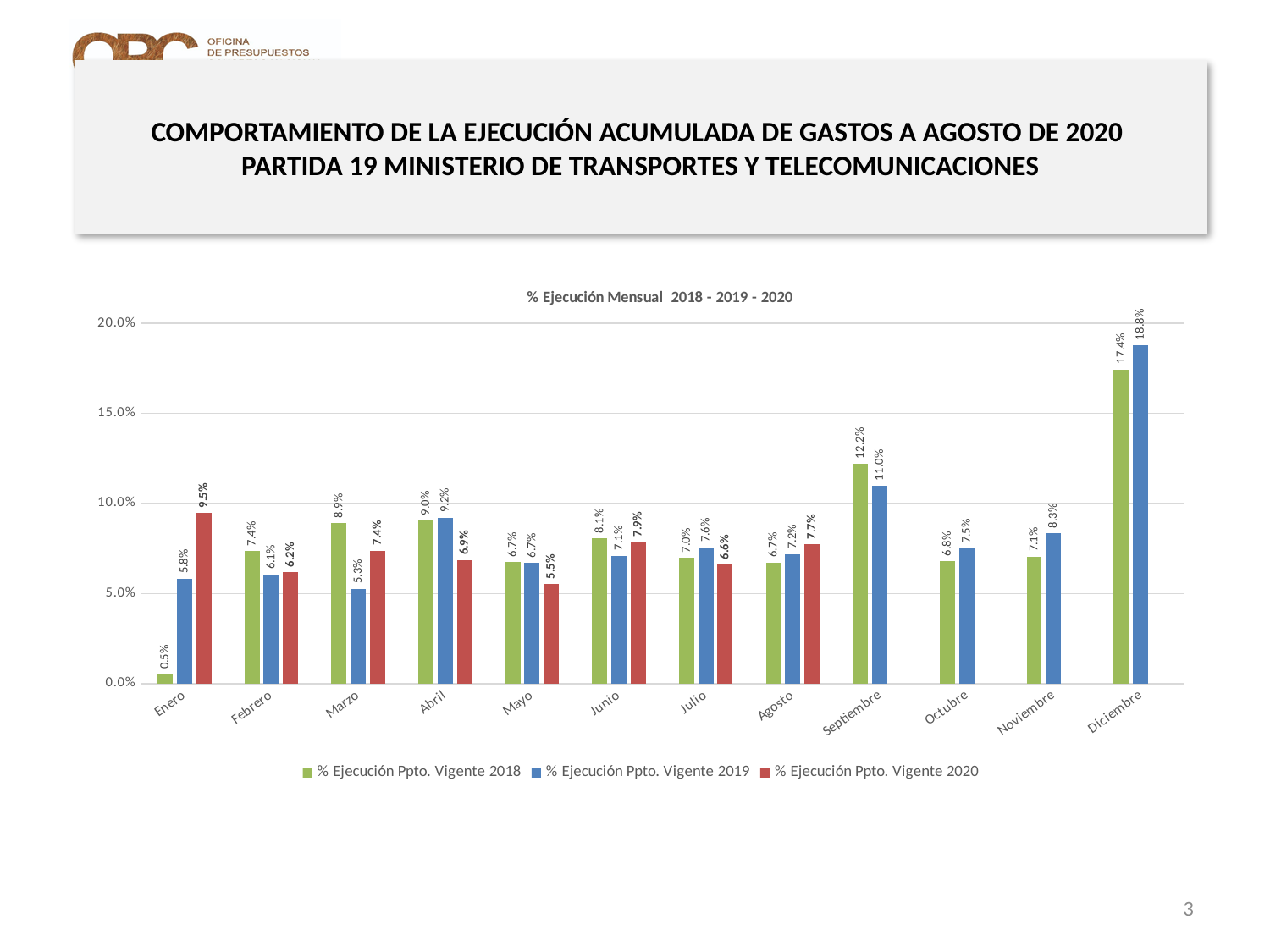
Which month has the lowest value for % Ejecución Ppto. Vigente 2018? Enero How many months are shown on the x axis? 12 Which month has the lowest value for % Ejecución Ppto. Vigente 2020? Mayo What kind of chart is shown on the slide? Bar chart What is the difference between the 2019 and 2018 values in Diciembre? 1.4% What is the value for % Ejecución Ppto. Vigente 2018 in Septiembre? 12.2% What is the value for % Ejecución Ppto. Vigente 2020 in Enero? 9.5% Is the value for % Ejecución Ppto. Vigente 2019 in Septiembre greater or less than 10.0%? greater Which month has the highest value for % Ejecución Ppto. Vigente 2018? Diciembre How many series does the legend list? 3 What is the value for % Ejecución Ppto. Vigente 2019 in Diciembre? 18.8% In Marzo, which is larger: the 2018 value or the 2019 value? 2018